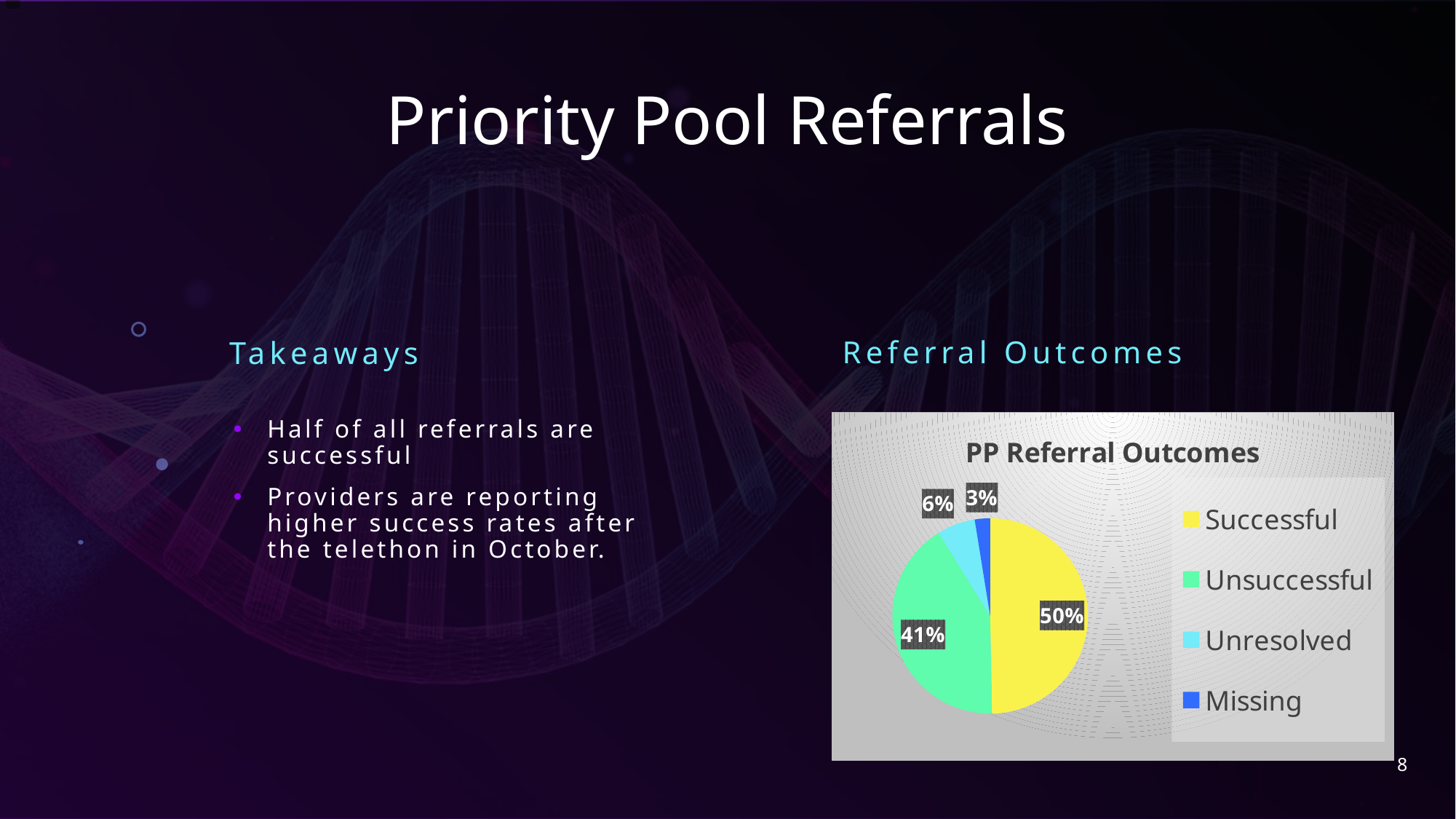
What share of referrals is Successful? 50% What share of referrals is Unresolved? 6% How many categories does the pie chart show? 4 What colour is the Successful slice? yellow Which is larger, the Unresolved slice or the Missing slice? Unresolved What share of referrals is Unsuccessful? 41% What share of referrals is Missing? 3% What is the title of the chart? PP Referral Outcomes Which category has the smallest slice of the pie? Missing What kind of chart is shown on the slide? pie chart Which category has the largest slice of the pie? Successful What is the difference in percentage points between Successful and Unsuccessful? 9